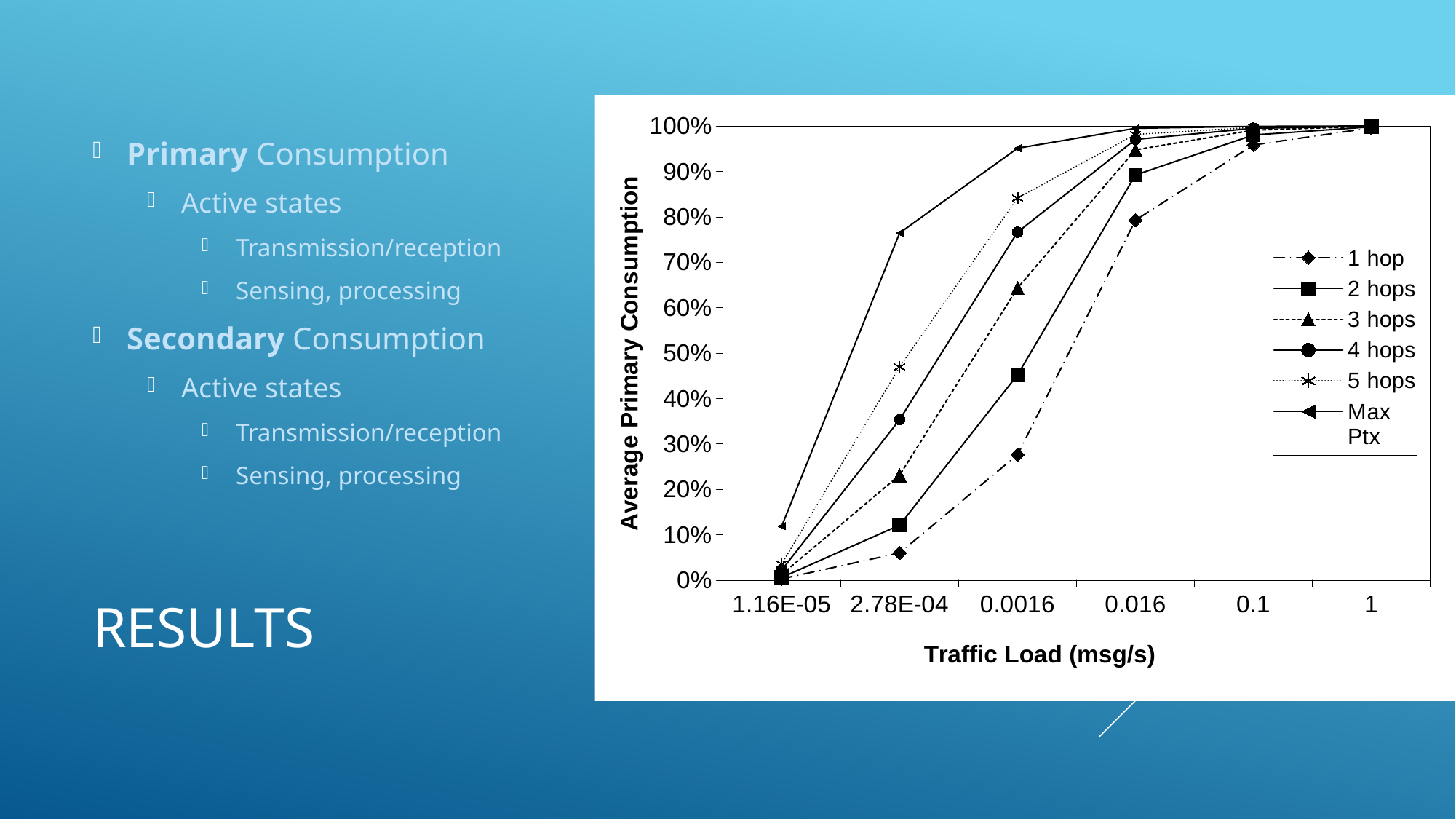
How many traffic load values are shown on the x axis? 6 Which series has the highest average primary consumption at a traffic load of 2.78E-04 msg/s? Max Ptx Is the value for 3 hops at 0.0016 msg/s greater or less than 60%? greater Is the value for Max Ptx at 2.78E-04 msg/s greater or less than 70%? greater Which series has the lowest average primary consumption at a traffic load of 0.0016 msg/s? 1 hop Do the values for the 1 hop series rise or fall as traffic load increases along the x axis? rise What is the title of the x axis? Traffic Load (msg/s) What kind of chart is shown on the slide? line chart At a traffic load of 0.0016 msg/s, which is larger: the value for 4 hops or the value for 2 hops? 4 hops Is the value for 1 hop at 0.0016 msg/s greater or less than 20%? greater How many series does the legend list? 6 What is the title of the y axis? Average Primary Consumption